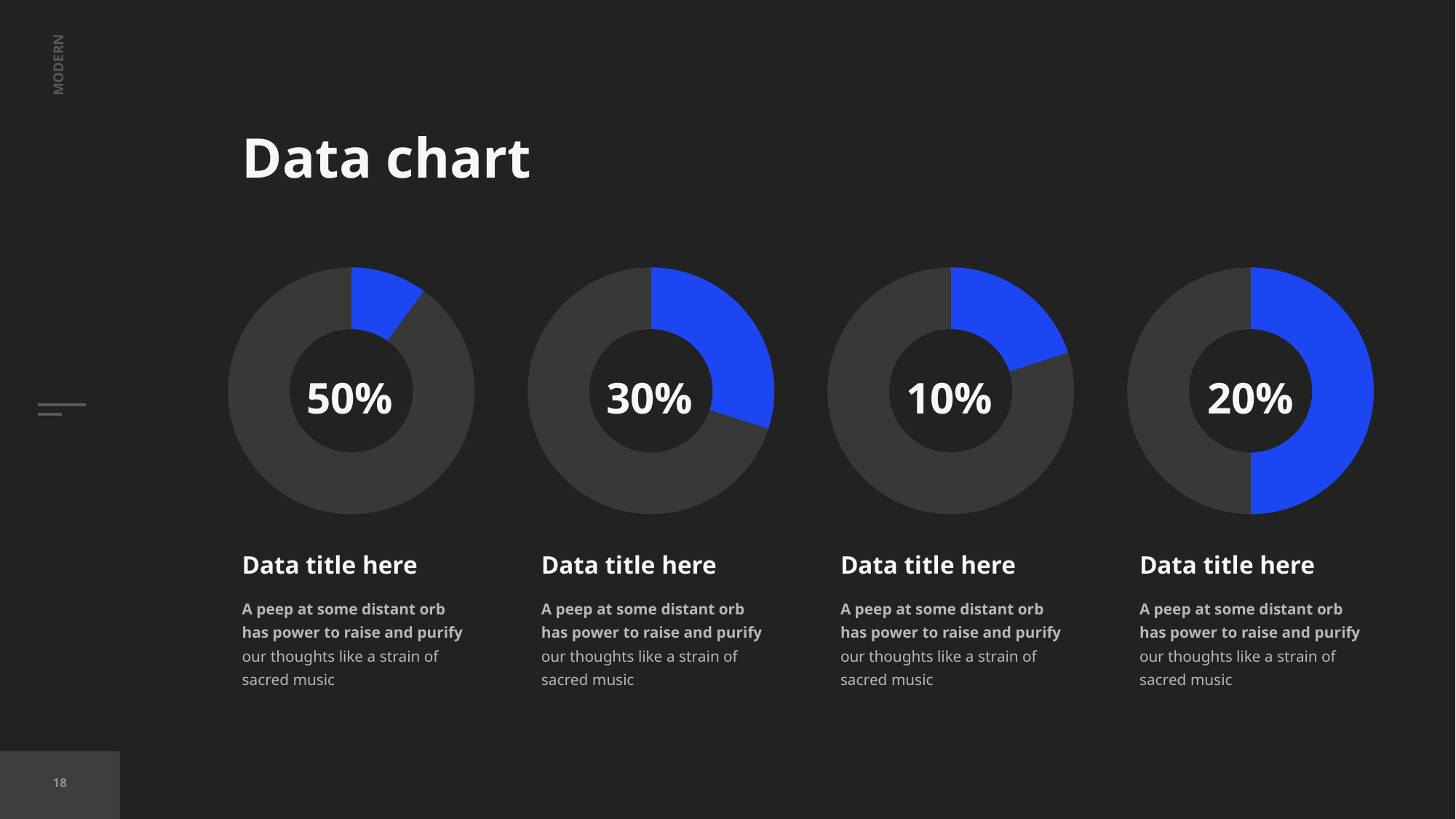
What percentage is printed in the centre of the leftmost donut chart? 50% How many donut charts are shown on the slide? 4 Which printed percentage is larger: the second donut chart from the left or the rightmost donut chart? The second chart from the left (30%) What kind of chart is used on this slide? Donut (pie) chart Which donut chart shows the highest printed percentage? The leftmost chart (50%) What is the title of the slide? Data chart Which donut chart shows the lowest printed percentage? The third chart from the left (10%) What percentage is printed in the centre of the third donut chart from the left? 10% What percentage is printed in the centre of the second donut chart from the left? 30% What colour is used for the highlighted segment in each donut chart? Blue What percentage is printed in the centre of the rightmost donut chart? 20% What is the difference between the percentage printed in the leftmost donut chart and the percentage printed in the rightmost donut chart? 30%